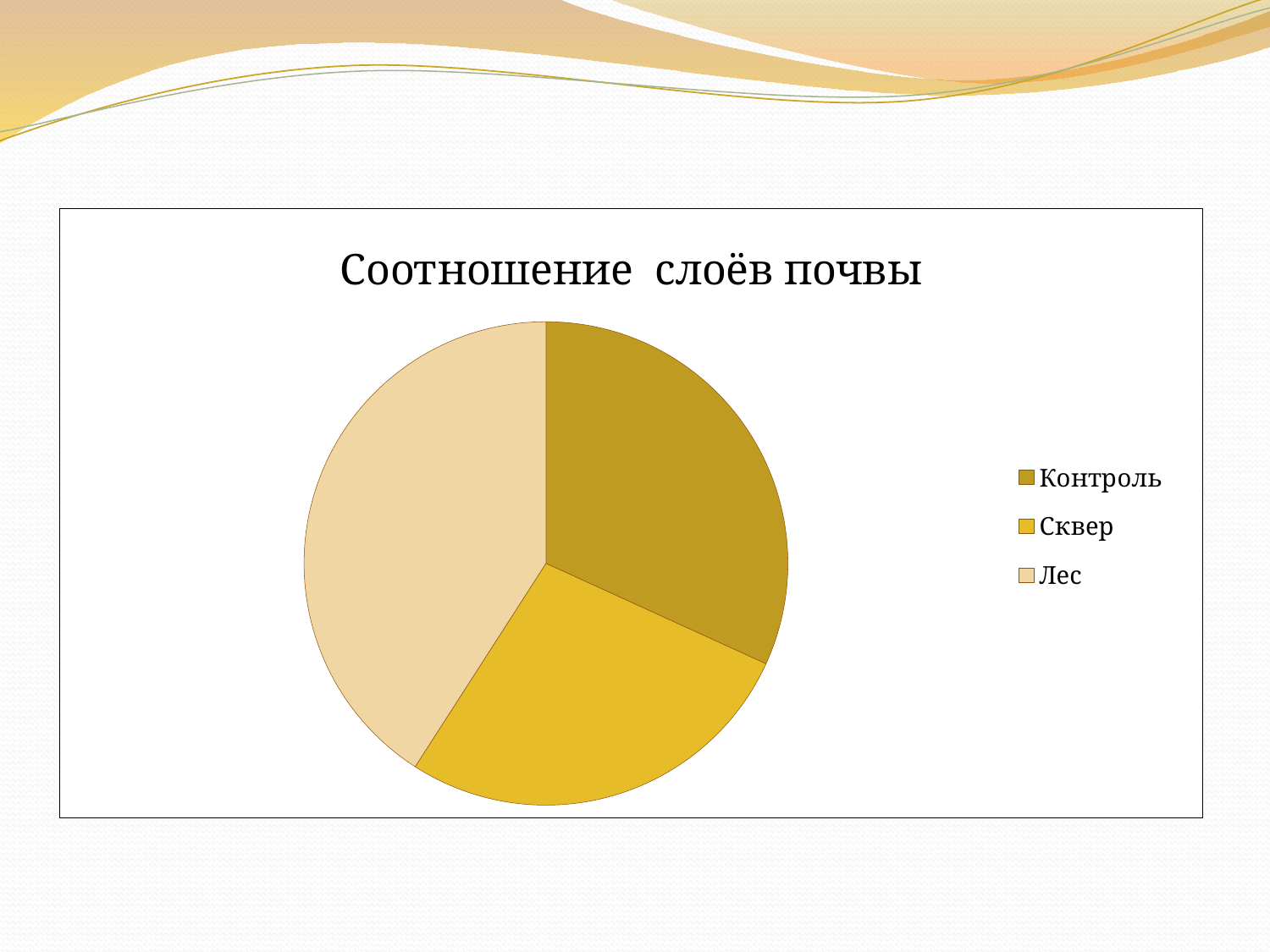
Which slice is larger, Лес or Контроль? Лес What kind of chart is shown on the slide? pie chart How many entries does the legend list? 3 What is the title of the chart? Соотношение слоёв почвы Which slice is larger, Лес or Сквер? Лес Which category has the smallest slice of the pie? Сквер How many slices does the pie chart have? 3 Which legend entry is listed first? Контроль Which category has the largest slice of the pie? Лес